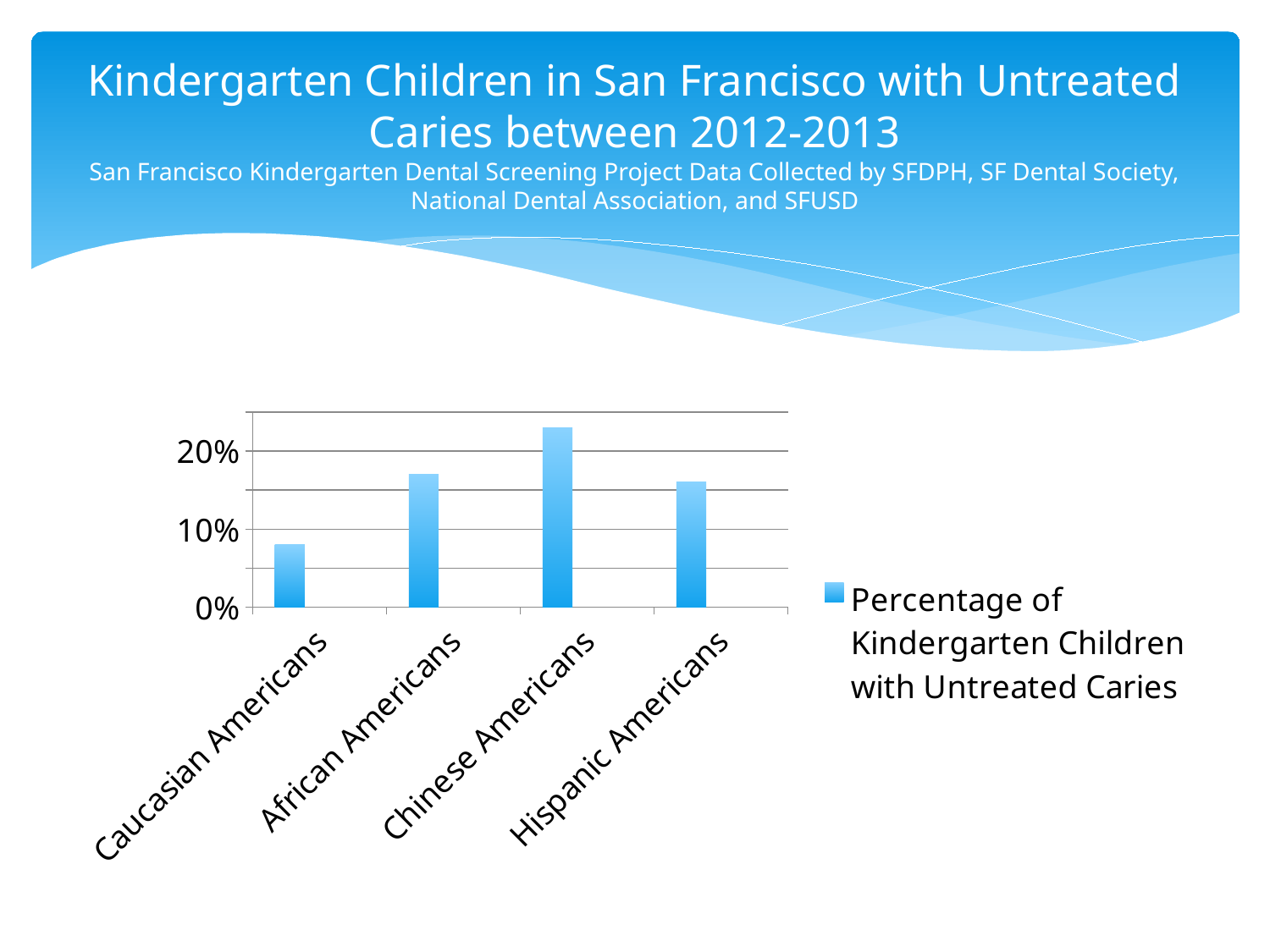
Is the value for Chinese Americans greater or less than 20%? greater Is the value for African Americans greater or less than 10%? greater Is the value for Hispanic Americans greater or less than 20%? less Which is larger, the value for Chinese Americans or the value for Caucasian Americans? Chinese Americans Which category has the lowest percentage of kindergarten children with untreated caries? Caucasian Americans What kind of chart is shown on the slide? Bar chart Which is larger, the value for African Americans or the value for Caucasian Americans? African Americans How many categories are plotted on the x axis of the chart? 4 What is the series name shown in the chart's legend? Percentage of Kindergarten Children with Untreated Caries Which category has the highest percentage of kindergarten children with untreated caries? Chinese Americans How many series does the chart's legend list? 1